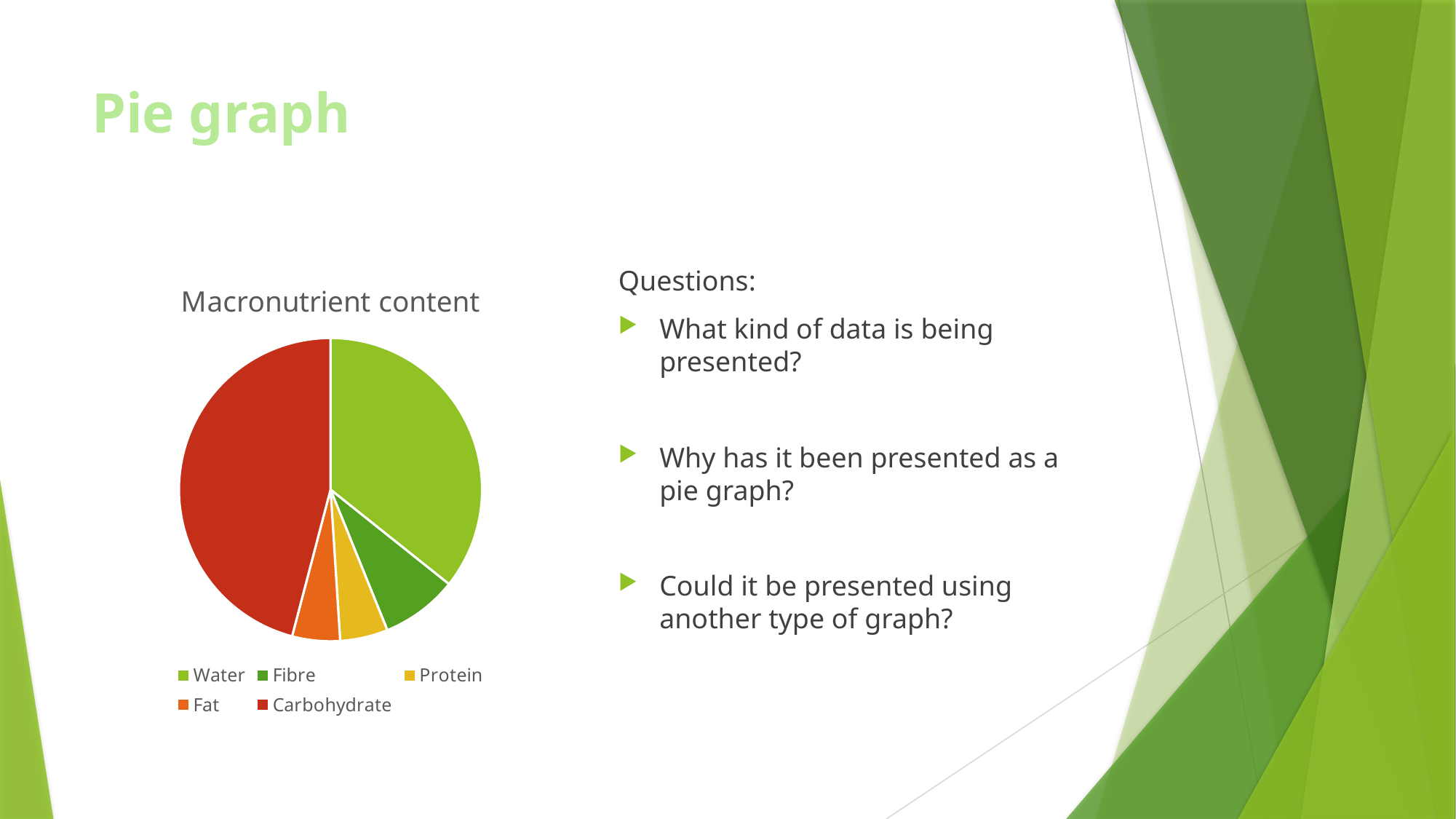
Which category is shown in red in the pie chart? Carbohydrate Which category has the largest slice of the pie? Carbohydrate Which slice is larger, Carbohydrate or Water? Carbohydrate What is the title of the chart? Macronutrient content What kind of chart is shown on the slide? Pie chart How many categories (slices) does the pie chart have? 5 Which slice is larger, Water or Fat? Water Which slice is larger, Water or Fibre? Water How many entries does the chart legend list? 5